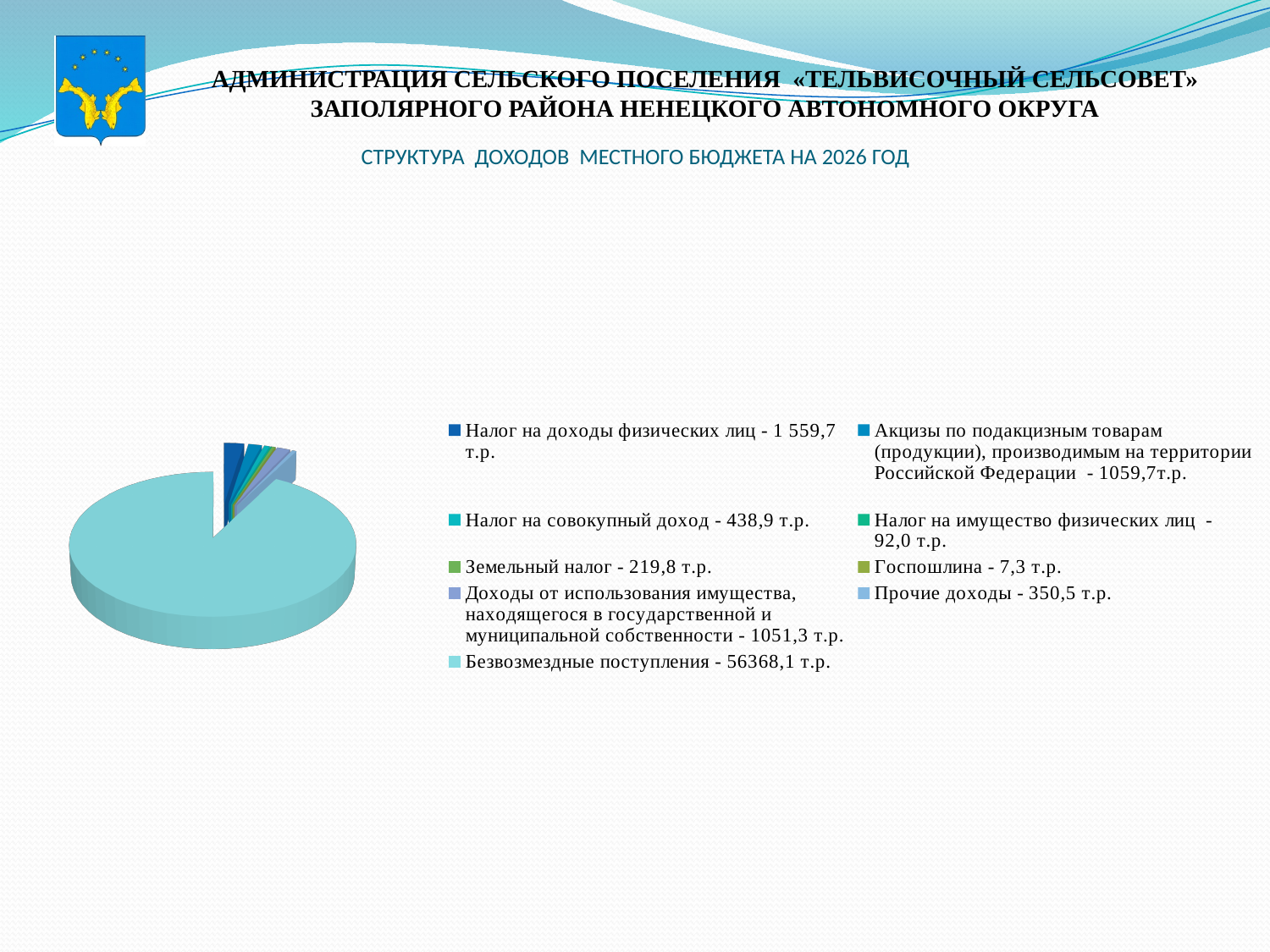
Which category has the smallest value in the pie chart? Госпошлина What is the value for Госпошлина? 7,3 т.р. What is the difference between Земельный налог and Налог на имущество физических лиц? 127,8 т.р. What is the value for Прочие доходы? 350,5 т.р. How many categories does the pie chart legend list? 9 Which category has the largest value in the pie chart? Безвозмездные поступления What is the title of the chart on the slide? СТРУКТУРА ДОХОДОВ МЕСТНОГО БЮДЖЕТА НА 2026 ГОД What is the value for Налог на доходы физических лиц? 1 559,7 т.р. What is the value for Безвозмездные поступления? 56368,1 т.р. What is the difference between Налог на доходы физических лиц and Акцизы по подакцизным товарам? 500,0 т.р. What kind of chart is shown on the slide? Pie chart Which is larger: Налог на совокупный доход or Прочие доходы? Налог на совокупный доход